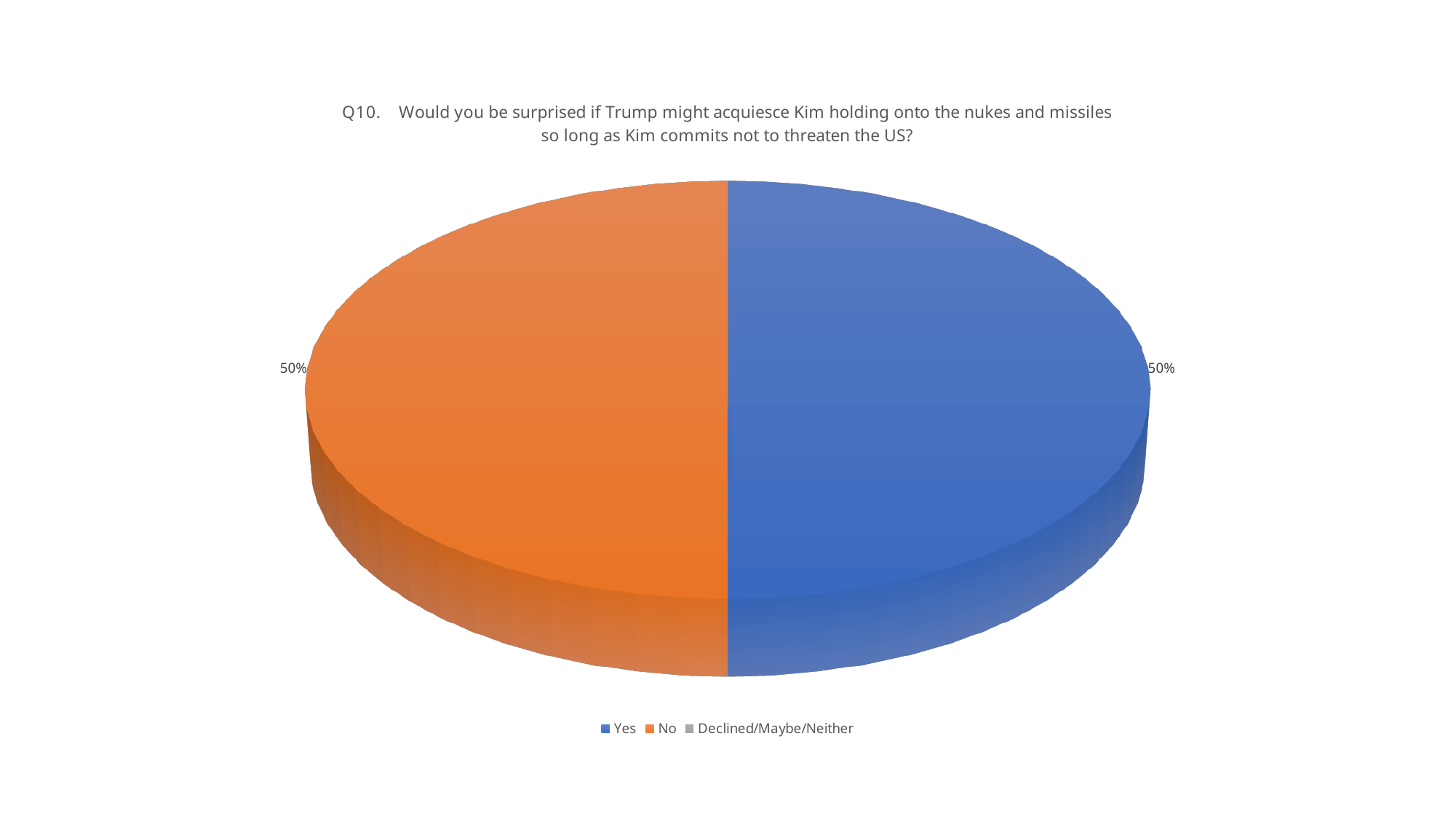
What share of the pie does the "No" slice represent? 50% What is the difference between the "Yes" share and the "No" share? 0% How many entries does the legend list? 3 What share of the pie does the "Yes" slice represent? 50% Is the share for "Yes" greater or less than 25%? greater Which legend entry has no visible slice in the pie? Declined/Maybe/Neither What kind of chart is shown on the slide? Pie chart Which colour represents "No" in the chart? Orange What is the combined share of the "Yes" and "No" slices? 100% How many slices are visible in the pie? 2